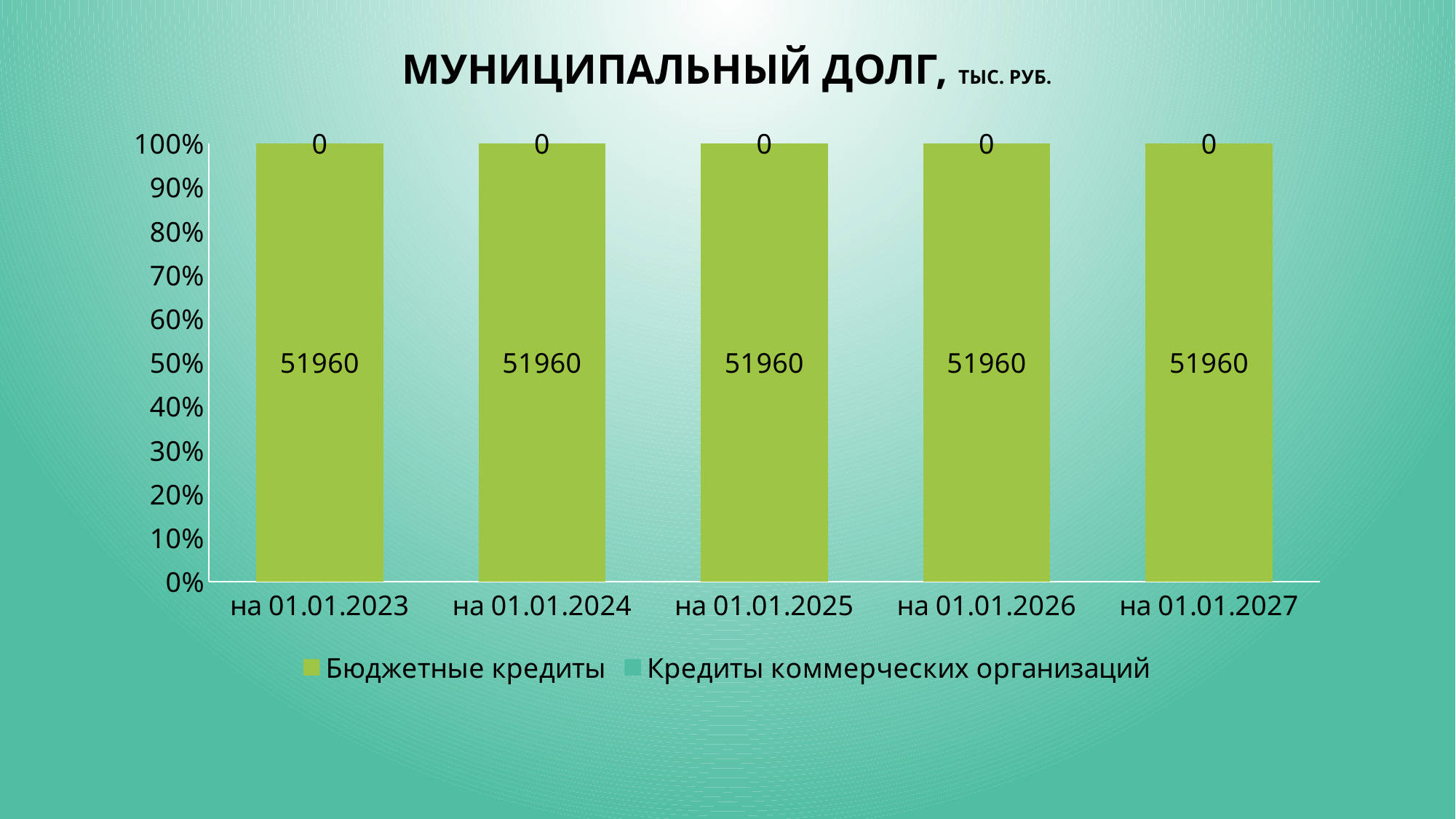
What is the title of the chart? МУНИЦИПАЛЬНЫЙ ДОЛГ, тыс. руб. What is the total of the stacked bar for на 01.01.2024? 51960 What is the value of Кредиты коммерческих организаций for на 01.01.2025? 0 Which is larger for на 01.01.2026: Бюджетные кредиты or Кредиты коммерческих организаций? Бюджетные кредиты What kind of chart is shown on the slide? Stacked bar chart What is the difference between Бюджетные кредиты and Кредиты коммерческих организаций for на 01.01.2023? 51960 How many series does the legend list? 2 How many categories (dates) are shown on the x axis? 5 What is the value of Бюджетные кредиты for на 01.01.2023? 51960 Does the value of Бюджетные кредиты rise, fall or stay the same from на 01.01.2023 to на 01.01.2027? Stays the same What is the value of Бюджетные кредиты for на 01.01.2027? 51960 What is the unit of measurement given in the chart title? тыс. руб.